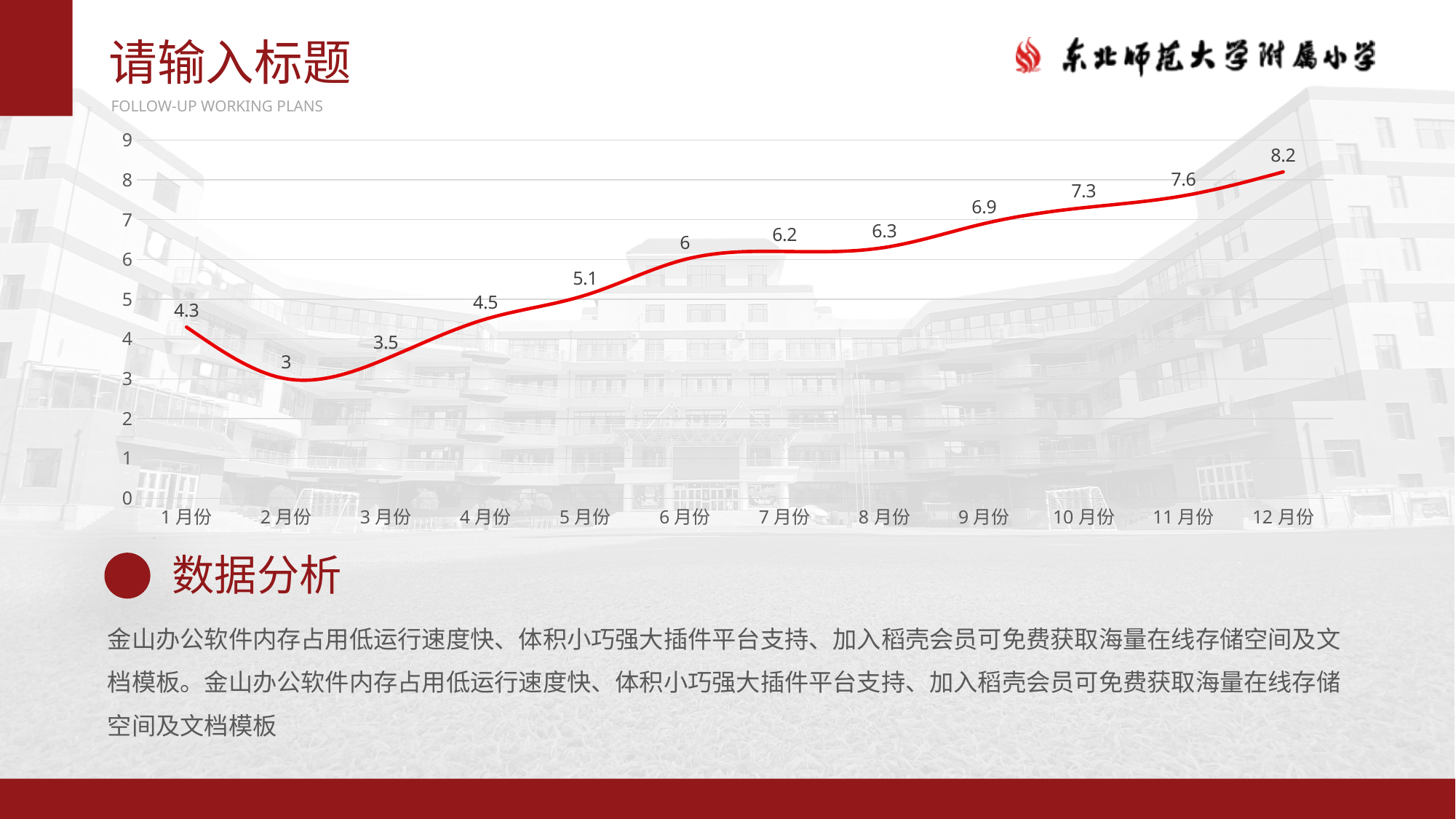
What kind of chart is shown on the slide? line chart Which is larger, the value for 1月份 or the value for 3月份? 1月份 What is the value for 6月份? 6 What is the value for 12月份? 8.2 What is the value for 1月份? 4.3 Is the value for 10月份 greater or less than 7? greater Which month has the highest value? 12月份 How many months are plotted on the x axis? 12 What is the difference between the values for 12月份 and 1月份? 3.9 Which month has the lowest value? 2月份 What is the difference between the values for 9月份 and 8月份? 0.6 Do the values rise or fall from 2月份 to 12月份? rise